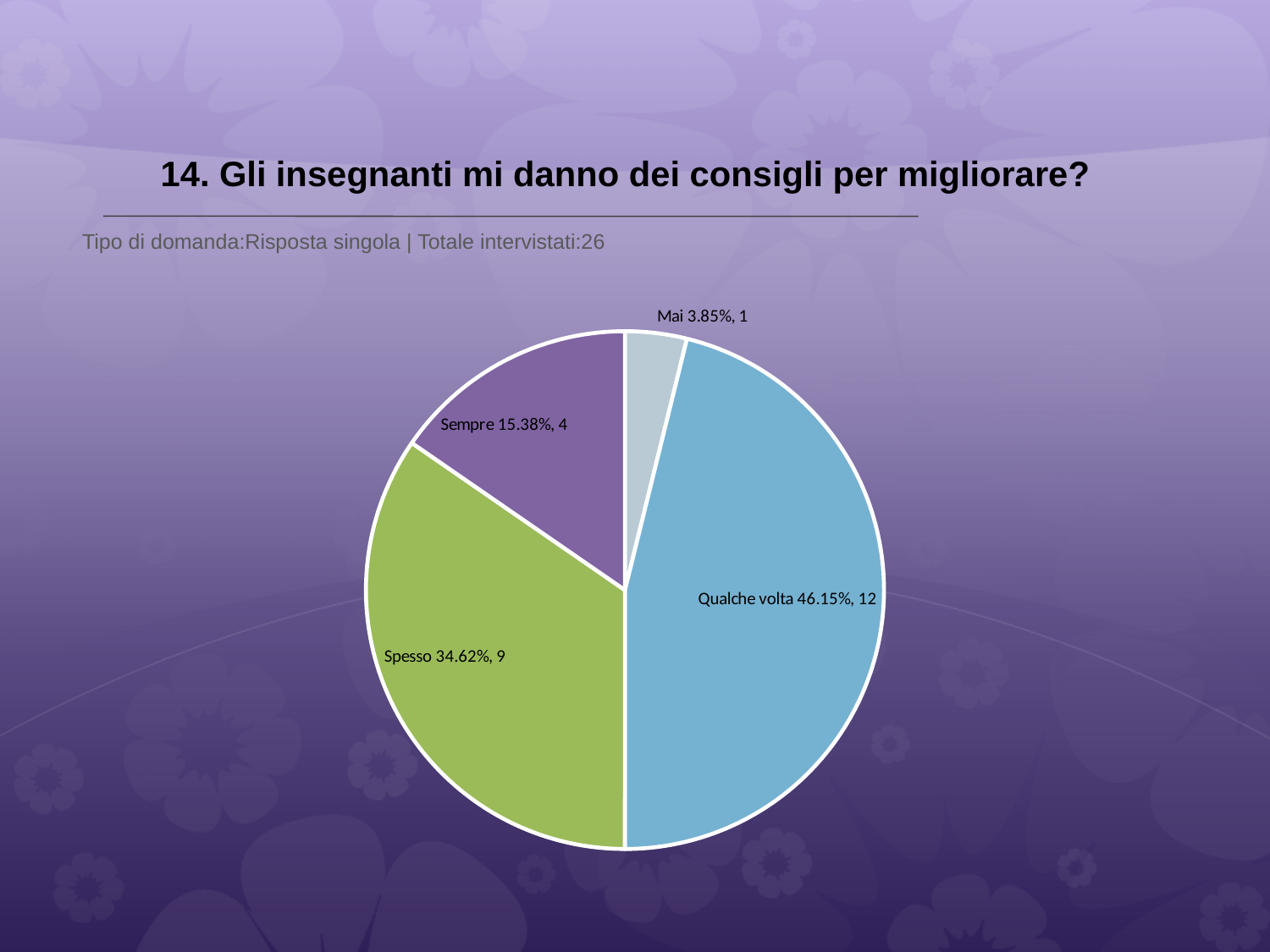
What percentage share does the 'Sempre' slice have? 15.38% How many slices does the pie chart have? 4 What kind of chart is shown on the slide? pie chart Which response has the largest slice of the pie? Qualche volta What is the total number of respondents across all slices? 26 What percentage share does the 'Qualche volta' slice have? 46.15% What colour is the 'Spesso' slice? green What is the difference in number of respondents between 'Qualche volta' and 'Spesso'? 3 How many respondents answered 'Mai'? 1 Which response has the smallest slice of the pie? Mai Which has more respondents, 'Sempre' or 'Spesso'? Spesso How many respondents answered 'Spesso'? 9